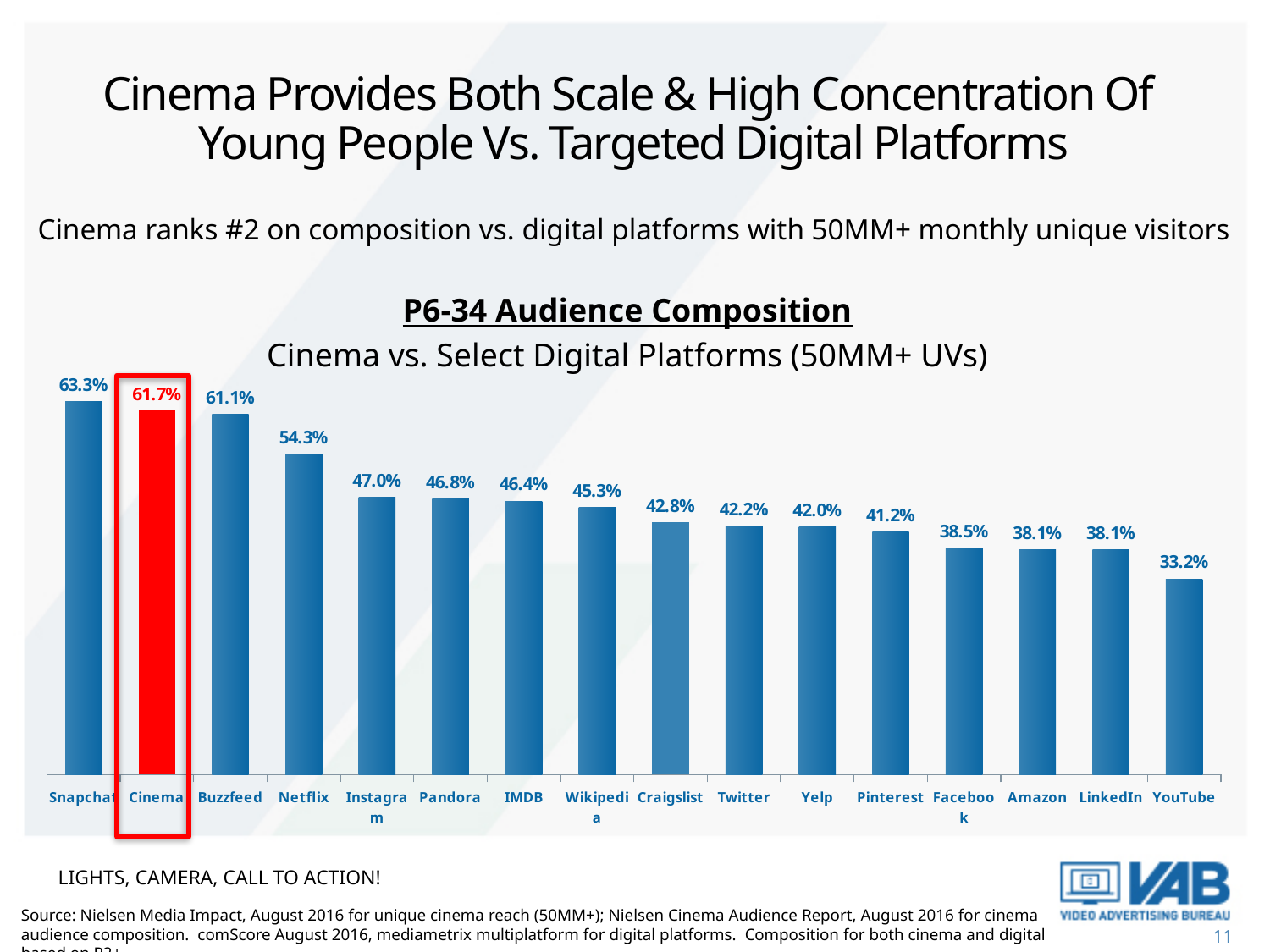
What is the value shown for Netflix? 54.3% Which has a higher value, Netflix or Instagram? Netflix Do the values rise or fall from left to right across the chart? Fall What is the value shown for Pinterest? 41.2% What kind of chart is shown on the slide? Bar chart What is the difference between Snapchat's value and Cinema's value? 1.6% Which has a higher value, Facebook or Twitter? Twitter What is the difference between Cinema's value and YouTube's value? 28.5% How many platforms are shown in the chart? 16 Which platform has the lowest P6-34 audience composition? YouTube What is the P6-34 audience composition value for Cinema? 61.7% Which platform has the highest P6-34 audience composition? Snapchat